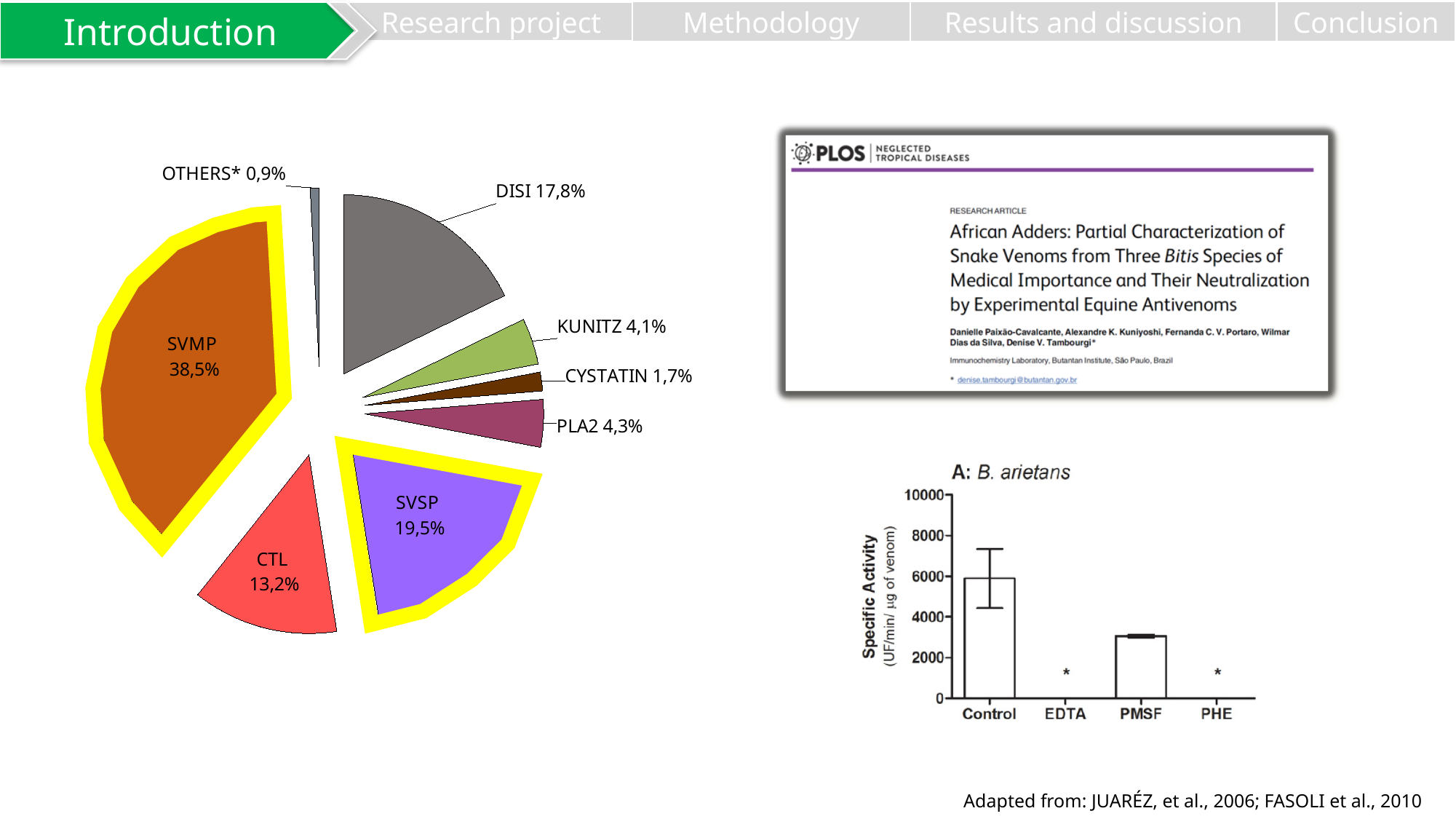
In the pie chart on the left, how many slices are there? 8 What kind of chart is the 'A: B. arietans' chart on the right? bar chart In the pie chart on the left, which is larger, CTL or DISI? DISI In the 'A: B. arietans' chart, is the value for Control greater or less than 4000? greater In the pie chart on the left, what is the difference between SVMP and SVSP? 19,0% In the pie chart on the left, what is the value for CYSTATIN? 1,7% In the 'A: B. arietans' chart, is the value for PMSF greater or less than 4000? less In the pie chart on the left, which category has the largest slice? SVMP In the pie chart on the left, which slices are outlined in yellow? SVMP and SVSP In the pie chart on the left, which category has the smallest slice? OTHERS* In the pie chart on the left, what share does SVMP have? 38,5% In the pie chart on the left, what is the value for DISI? 17,8%